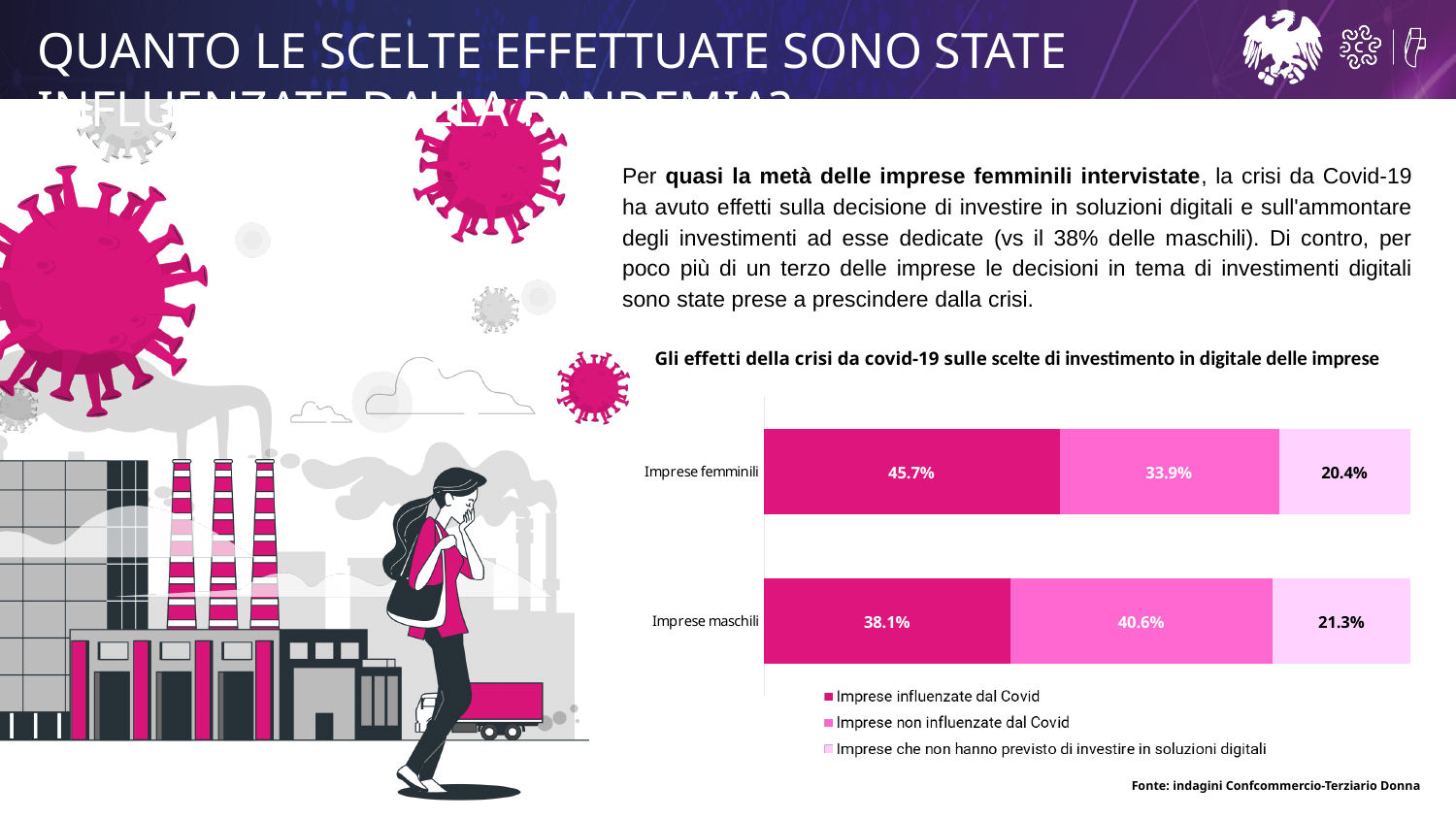
What is the difference between the Imprese non influenzate dal Covid share for Imprese maschili and for Imprese femminili? 6.7 percentage points What is the value for Imprese non influenzate dal Covid among Imprese femminili? 33.9% What is the difference between the Imprese influenzate dal Covid share for Imprese femminili and for Imprese maschili? 7.6 percentage points What type of chart is shown on the slide? Stacked bar chart What percentage of Imprese maschili are Imprese non influenzate dal Covid? 40.6% What is the value for Imprese che non hanno previsto di investire in soluzioni digitali among Imprese maschili? 21.3% What percentage of Imprese femminili are Imprese influenzate dal Covid? 45.7% Which category has the higher share of Imprese influenzate dal Covid, Imprese femminili or Imprese maschili? Imprese femminili Which series has the smallest share within the Imprese femminili bar? Imprese che non hanno previsto di investire in soluzioni digitali How many series does the legend list? 3 Which series has the largest share within the Imprese maschili bar? Imprese non influenzate dal Covid How many categories are shown on the chart? 2